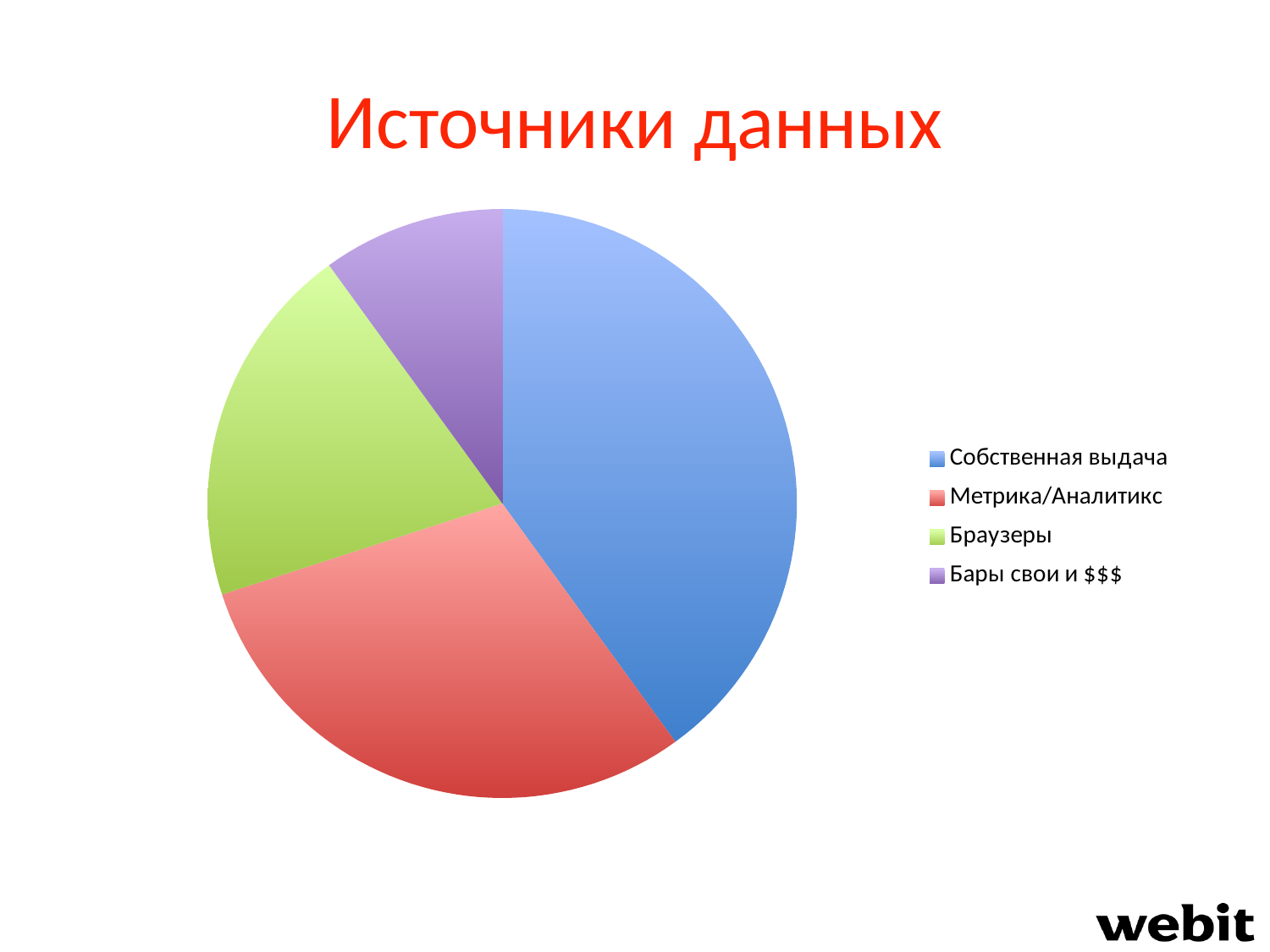
How many slices does the pie chart have? 4 Which slice is larger: Метрика/Аналитикс or Браузеры? Метрика/Аналитикс Which category has the smallest slice of the pie chart? Бары свои и $$$ Which category has the largest slice of the pie chart? Собственная выдача Which slice is larger: Браузеры or Бары свои и $$$? Браузеры What is the title of the slide with the pie chart? Источники данных What colour is the slice for Браузеры in the pie chart? green How many entries does the legend of the pie chart list? 4 Which slice is larger: Собственная выдача or Метрика/Аналитикс? Собственная выдача What kind of chart is shown on the slide? pie chart